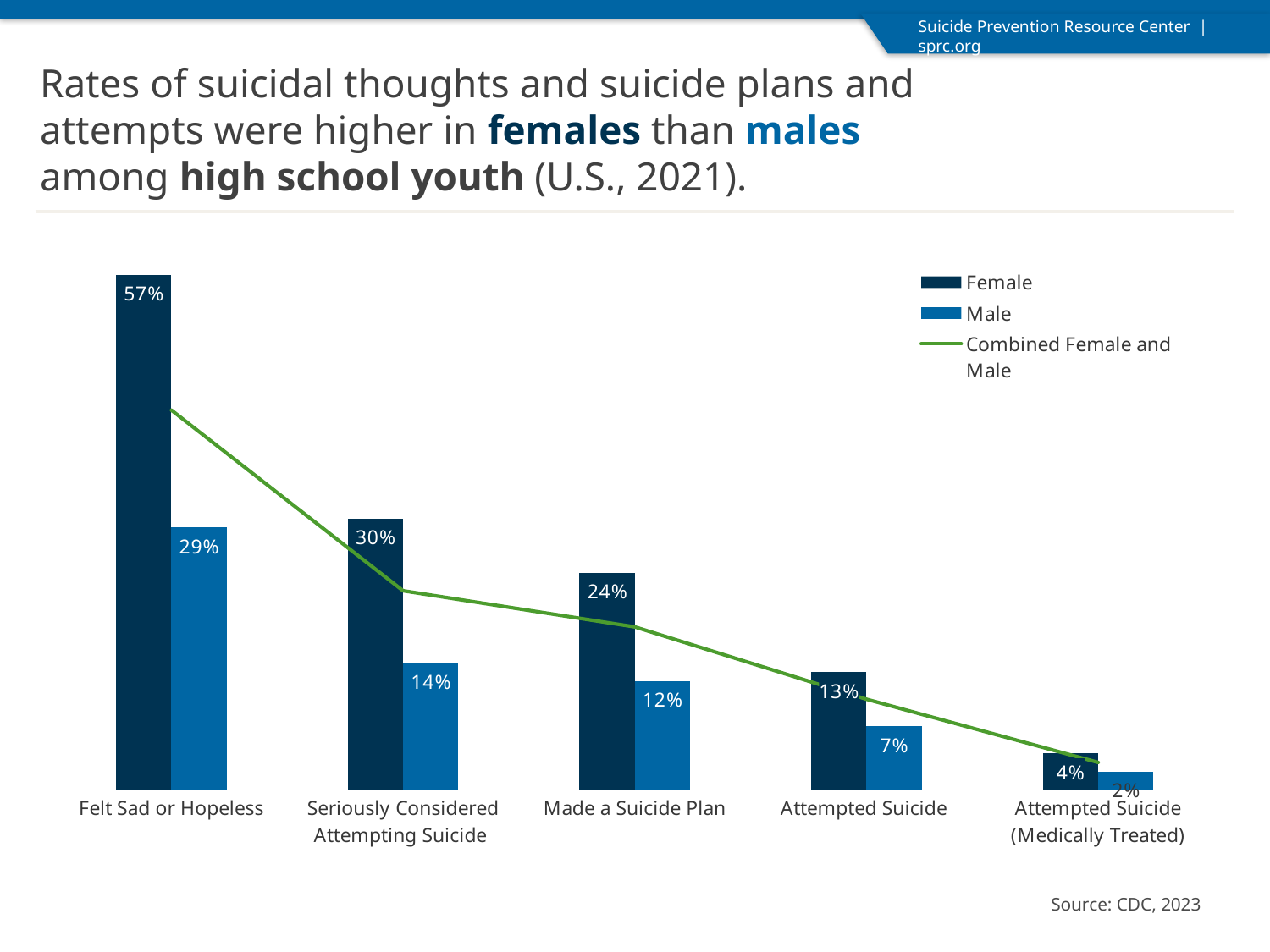
What is the source cited for the chart? CDC, 2023 Which is larger for Made a Suicide Plan, the Female value or the Male value? Female What is the difference between the Female and Male values for Felt Sad or Hopeless? 28% Which category has the highest Female value? Felt Sad or Hopeless Which category has the lowest Male value? Attempted Suicide (Medically Treated) How many series does the legend list? 3 What is the Male value for Seriously Considered Attempting Suicide? 14% Do the Female values rise or fall from left to right across the categories? fall What is the Female value for Felt Sad or Hopeless? 57% What is the Female value for Made a Suicide Plan? 24% What is the Male value for Attempted Suicide? 7% How many categories are shown on the x axis? 5